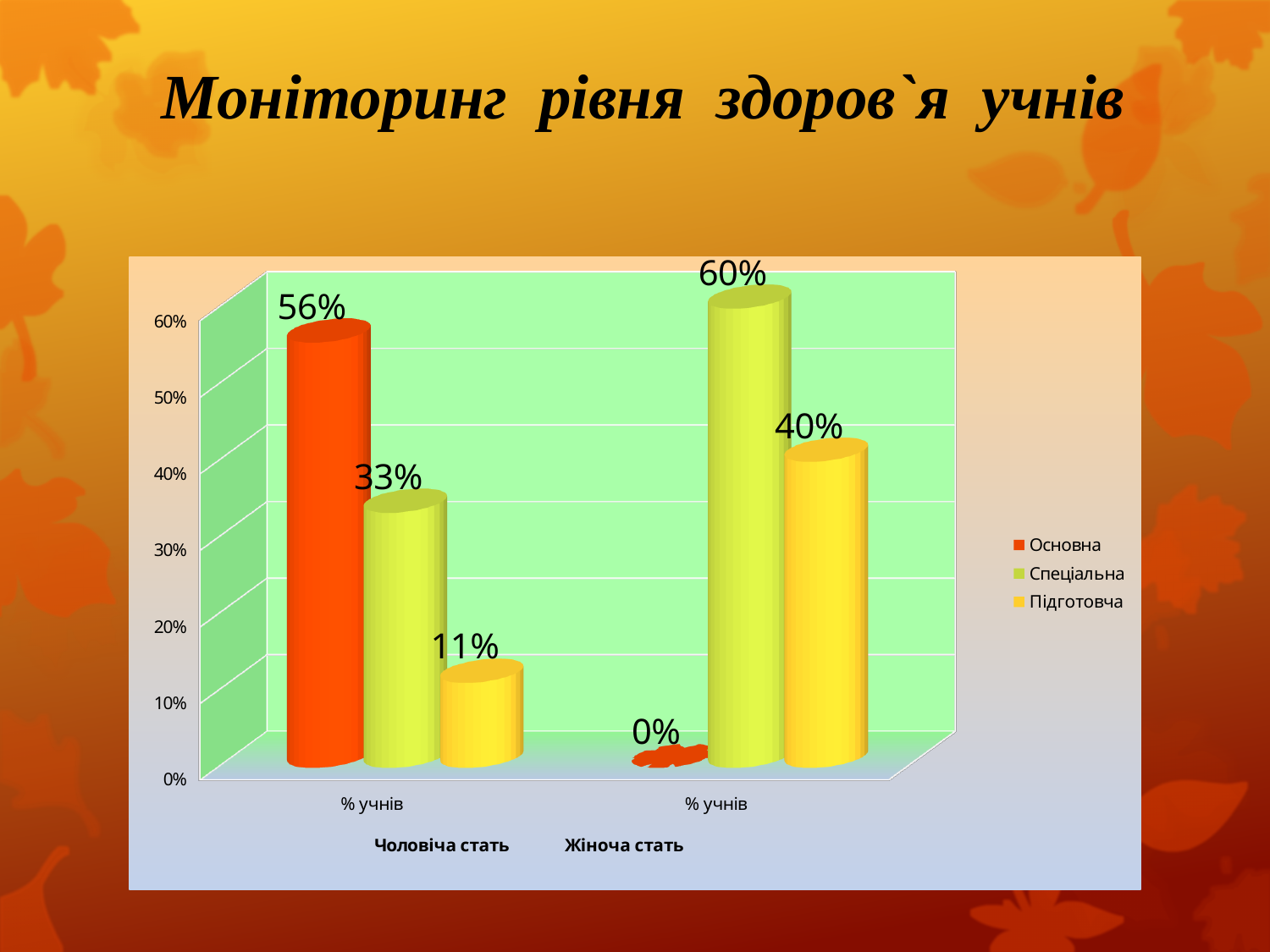
Which series has the lowest value in the Чоловіча стать group? Підготовча What is the value for Основна in the Жіноча стать group? 0% What is the value for Основна in the Чоловіча стать group? 56% What is the value for Підготовча in the Чоловіча стать group? 11% What is the difference between the Спеціальна values for Жіноча стать and Чоловіча стать? 27% What colour represents the Основна series? Red Which is larger: Підготовча for Жіноча стать or Спеціальна for Чоловіча стать? Підготовча for Жіноча стать What kind of chart is shown on the slide? Bar chart What is the value for Спеціальна in the Жіноча стать group? 60% What is the title of the slide? Моніторинг рівня здоров`я учнів How many series does the legend list? 3 Which series has the highest value in the Жіноча стать group? Спеціальна